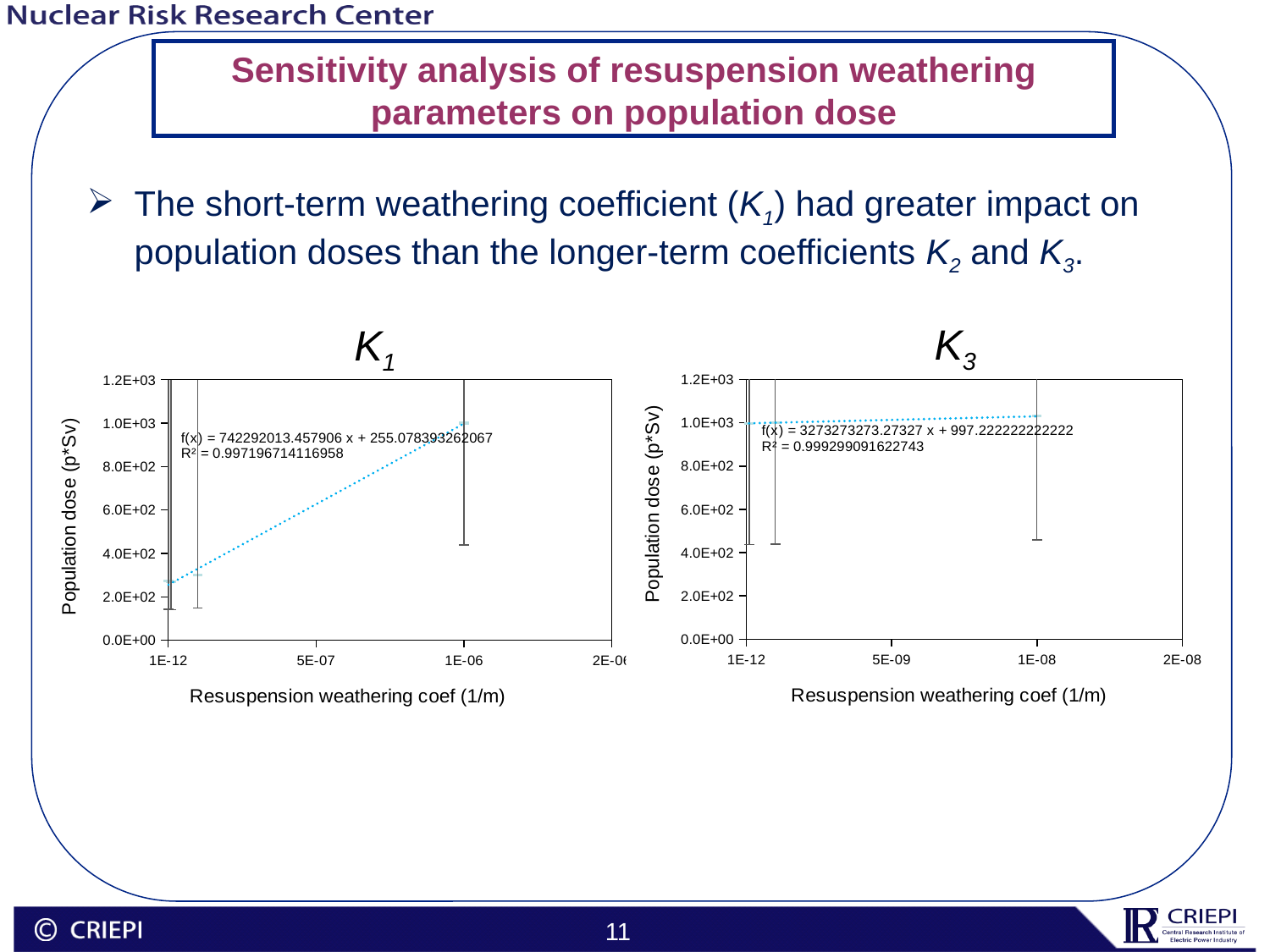
In the K1 chart, is the population dose at a weathering coefficient of 1E-06 greater or less than 8.0E+02? greater What is the R² value shown on the K3 chart? 0.999299091622743 In the K3 chart, is the population dose at a weathering coefficient of 1E-08 greater or less than 8.0E+02? greater How many data points are plotted in the K1 chart? 4 In the K1 chart, do the population dose values rise or fall as the resuspension weathering coefficient increases along the x axis? rise In the K1 chart, at which x-axis value is the population dose highest? 1E-06 In the K1 chart, is the population dose at a weathering coefficient of 1E-12 greater or less than 4.0E+02? less In the K1 chart, which is larger: the population dose at 1E-12 or at 1E-06? 1E-06 What is the maximum value shown on the y axis of the K3 chart? 1.2E+03 What kind of chart is the K1 chart on the left? scatter chart What is the R² value shown on the K1 chart? 0.997196714116958